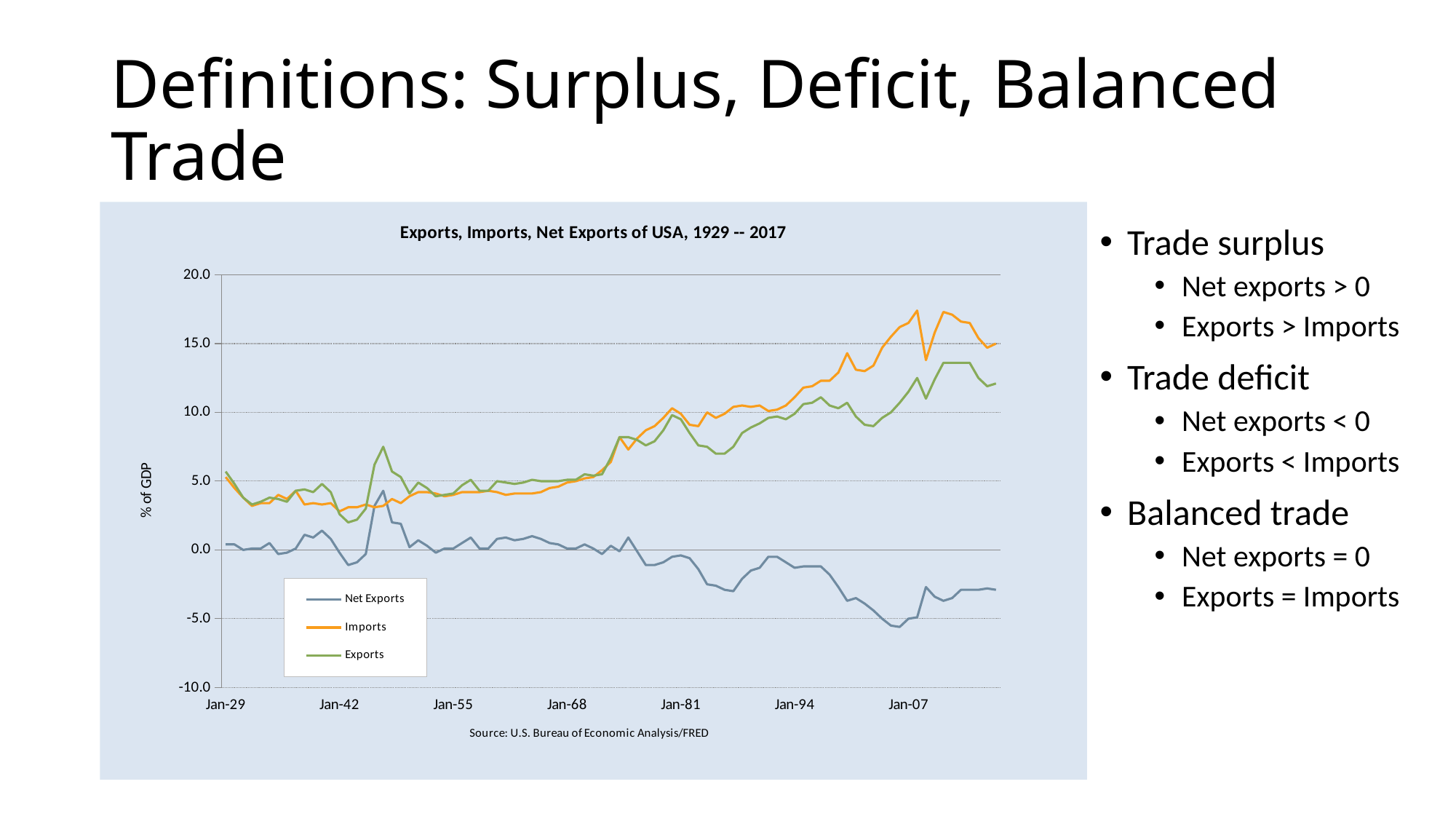
What is the label on the chart's vertical axis? % of GDP Which series reaches the highest value on the chart? Imports Do the Imports values rise or fall between Jan-68 and Jan-07? rise How many labelled tick marks are on the chart's x axis? 7 What kind of chart is shown on the slide? line chart What is the title of the chart? Exports, Imports, Net Exports of USA, 1929 -- 2017 Is the value for Net Exports at Jan-07 greater or less than 0.0? less At Jan-07, which is larger: Imports or Exports? Imports Is the value for Imports at Jan-07 greater or less than 15.0? greater Is the value for Imports at Jan-55 greater or less than 5.0? less How many series does the chart's legend list? 3